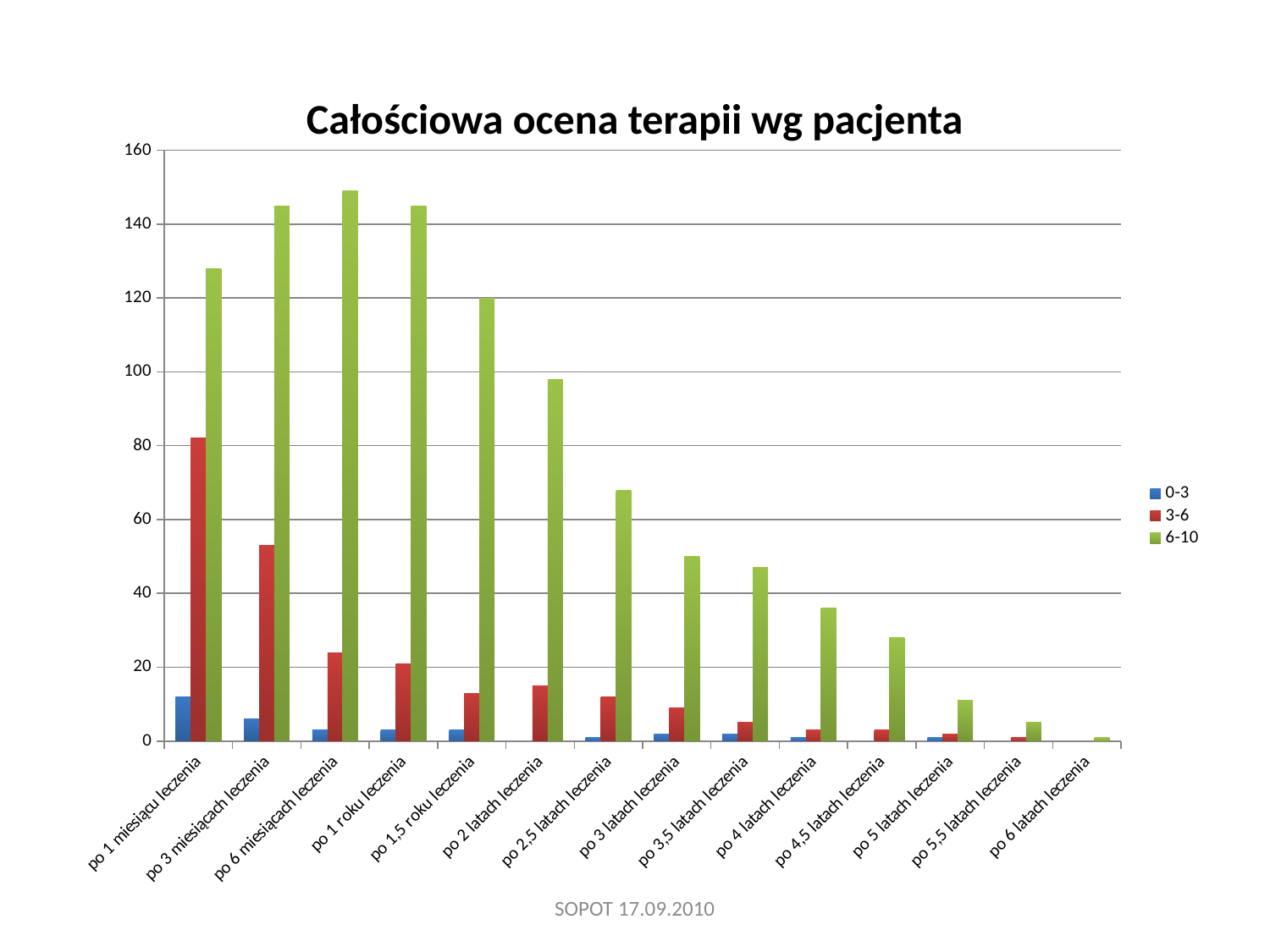
How many categories are shown along the x axis? 14 Is the value of the 3-6 series for po 1 miesiącu leczenia greater or less than 80? greater Which series is shown in green in the legend? 6-10 Which is larger for po 3 miesiącach leczenia: the 3-6 series or the 6-10 series? 6-10 Is the value of the 6-10 series for po 2 latach leczenia greater or less than 100? less From po 6 miesiącach leczenia onward, do the values of the 6-10 series rise or fall along the x axis? fall For which category is the 3-6 series highest? po 1 miesiącu leczenia What kind of chart is shown on the slide? bar chart What is the title of the chart? Całościowa ocena terapii wg pacjenta For which category is the 6-10 series highest? po 6 miesiącach leczenia Is the value of the 6-10 series for po 1 miesiącu leczenia greater or less than 120? greater How many series does the legend list? 3